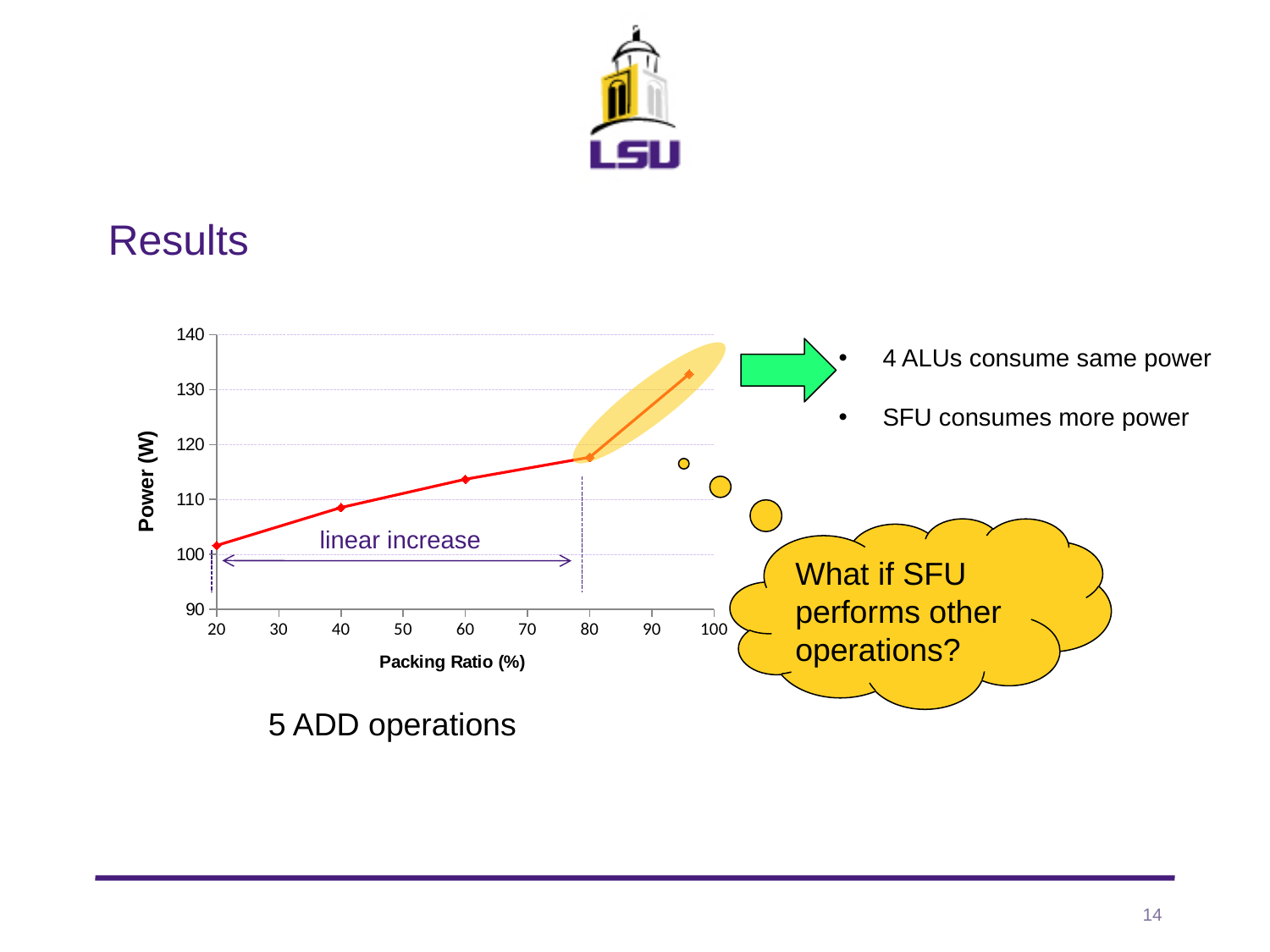
Is the power at a packing ratio of 80% greater or less than 110? greater What kind of chart is shown on the slide? line chart Is the power at a packing ratio of 20% greater or less than 110? less Is the power at the highest plotted packing ratio greater or less than 130? greater What is the title of the x axis of the chart? Packing Ratio (%) Is power higher at a packing ratio of 20% or at 80%? 80% How many data points are plotted on the line? 5 What is the title of the y axis of the chart? Power (W) Is power higher at a packing ratio of 60% or at 40%? 60% Does power rise or fall as the packing ratio increases? rises